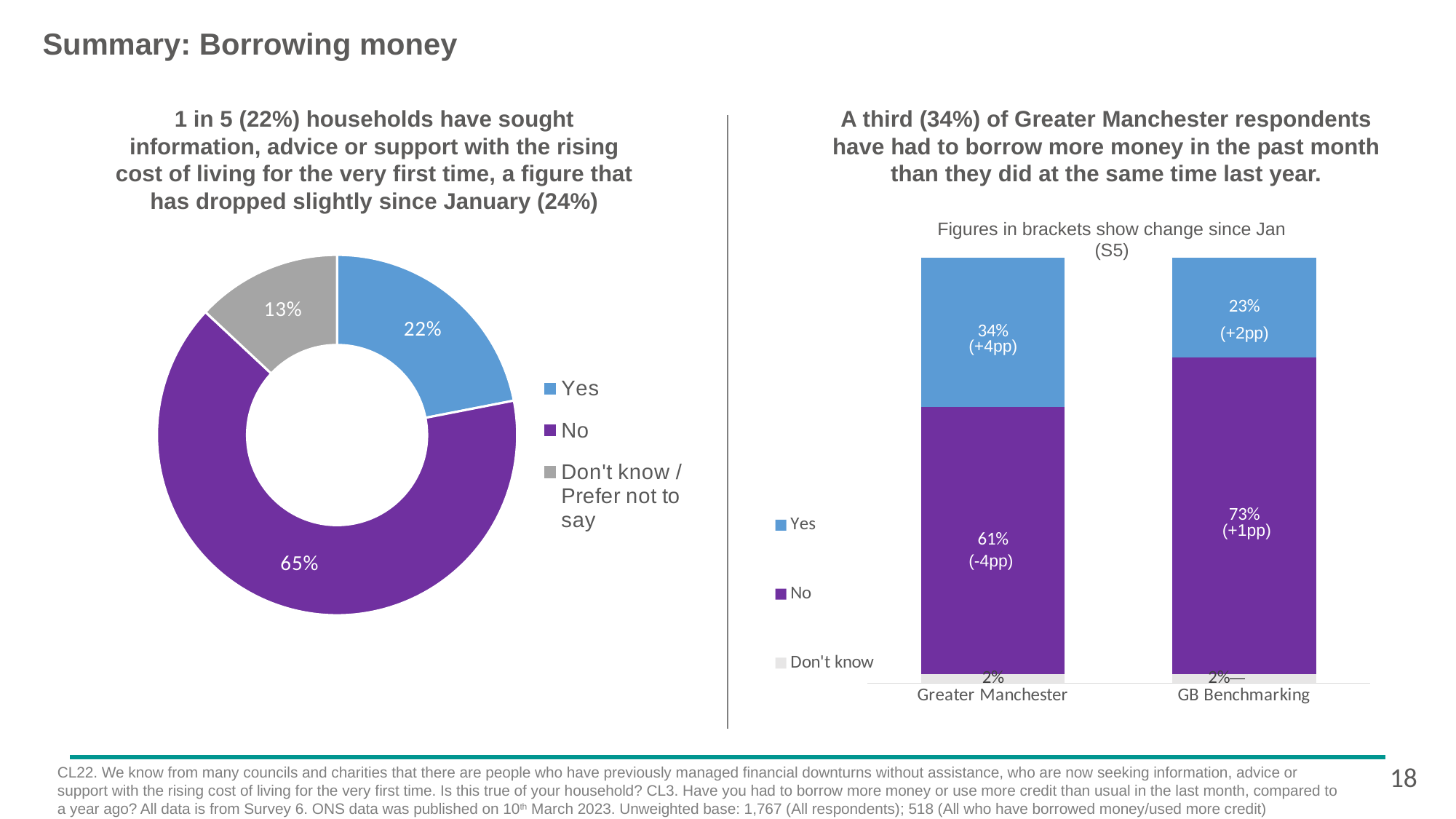
In the right-hand stacked bar chart, what is the No value for GB Benchmarking? 73% In the left-hand doughnut chart, what share of households answered Yes? 22% In the left-hand doughnut chart, which response has the largest share? No In the left-hand doughnut chart, what share of households answered No? 65% What type of chart is shown on the right-hand side of the slide? Stacked bar chart In the right-hand stacked bar chart, what is the Yes value for Greater Manchester? 34% In the right-hand stacked bar chart, which has the larger Yes value, Greater Manchester or GB Benchmarking? Greater Manchester In the right-hand stacked bar chart, how many series does the legend list? 3 In the left-hand doughnut chart, which response has the smallest share? Don't know / Prefer not to say In the right-hand stacked bar chart, what is the change since January shown for the Greater Manchester No value? -4pp In the left-hand doughnut chart, how many percentage points larger is the No share than the Yes share? 43 In the left-hand doughnut chart, what share answered Don't know / Prefer not to say? 13%